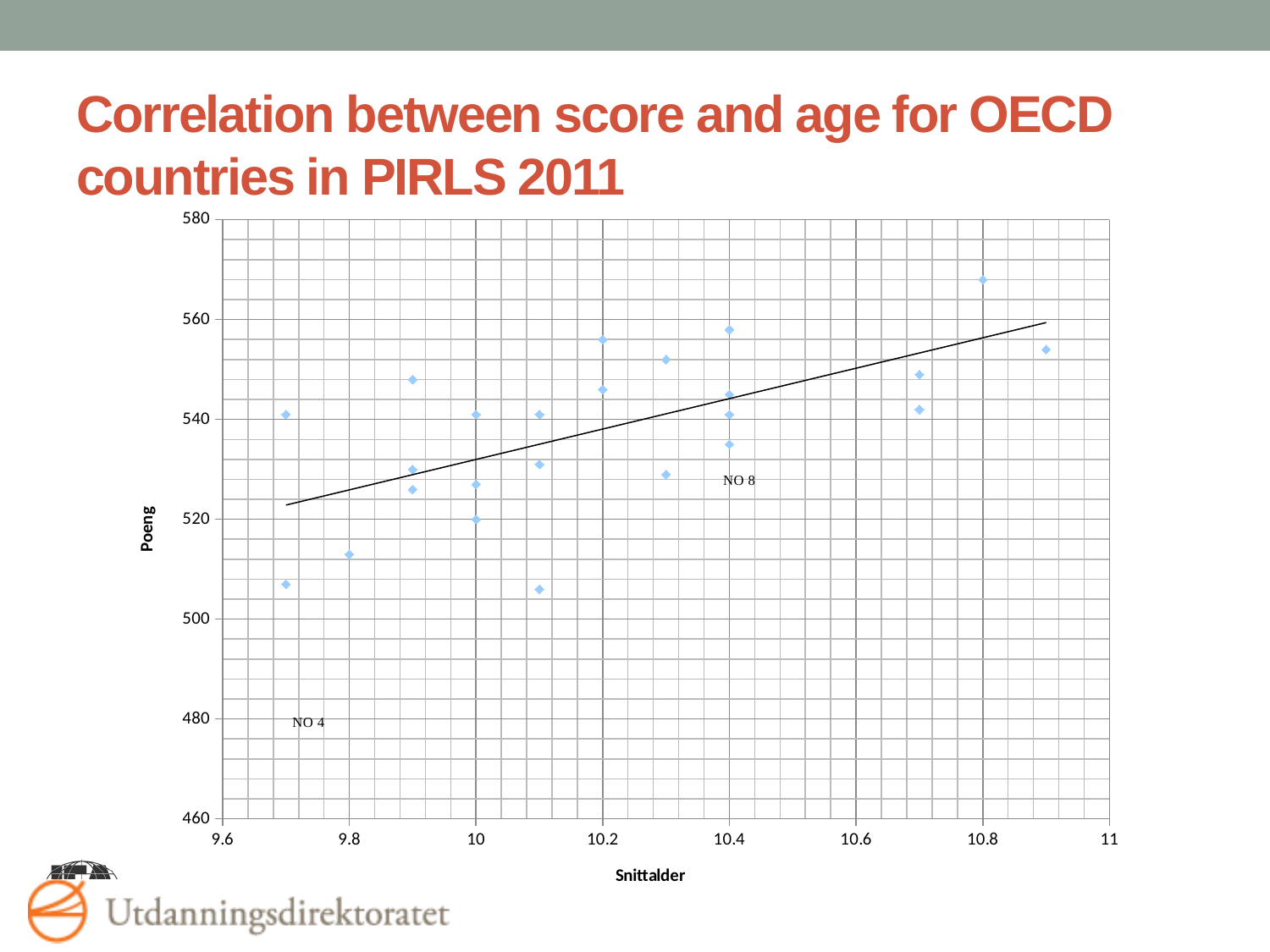
What is the label of the vertical axis? Poeng Is the value of the highest point (at Snittalder 10.8) greater or less than 560? greater At which Snittalder value does the highest-scoring point appear? 10.8 Does the trend line in the chart rise or fall as Snittalder increases? rise Is the value of the point at Snittalder 10.9 greater or less than 540? greater Is the value of the highest point at Snittalder 10.2 greater or less than 540? greater What kind of chart is shown on the slide? scatter plot What is the title of the chart on the slide? Correlation between score and age for OECD countries in PIRLS 2011 What is the lowest value shown on the vertical axis? 460 Which is larger: the point at Snittalder 10.8 or the point at Snittalder 9.8? the point at 10.8